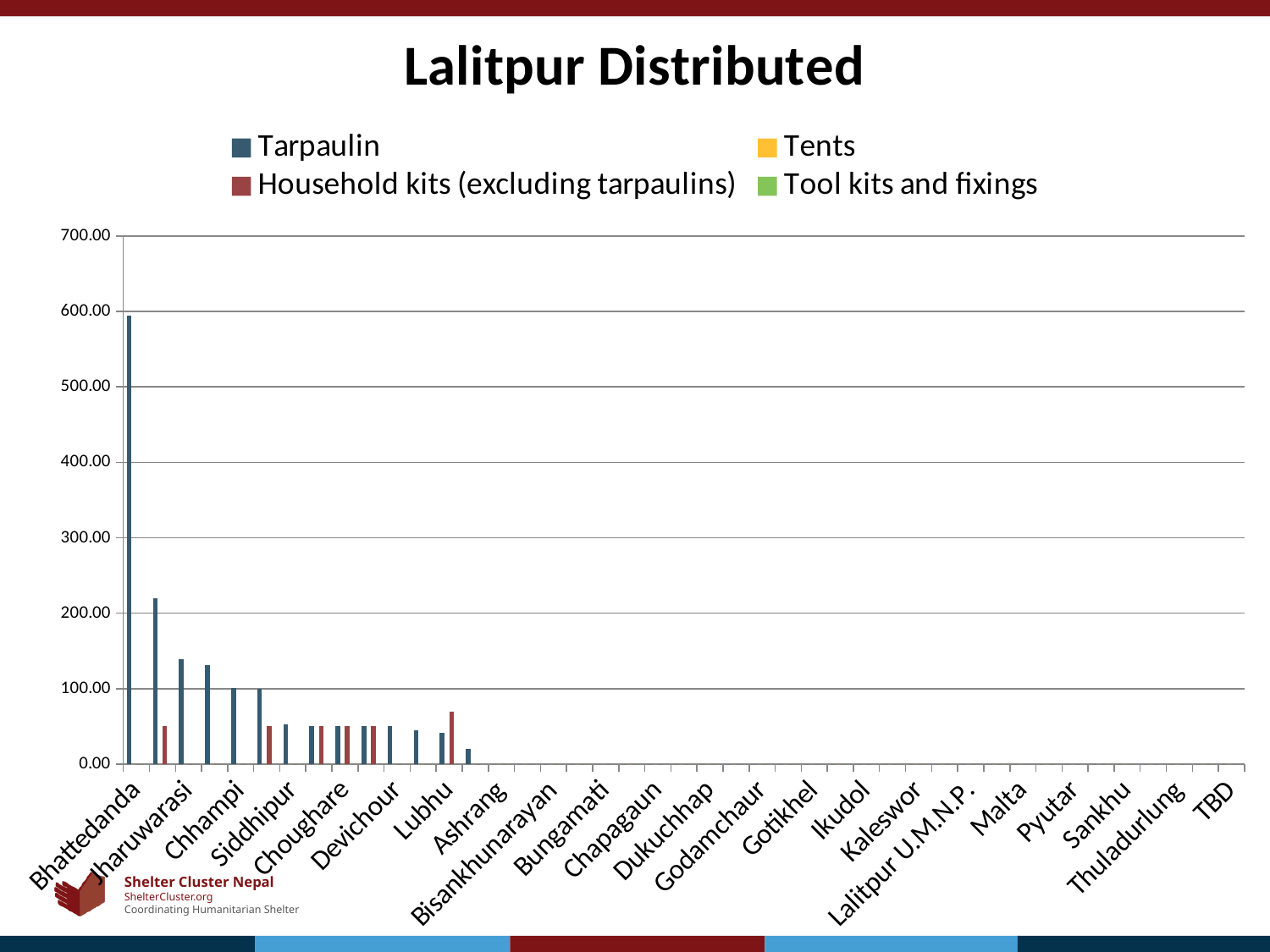
Is the Tarpaulin value for Bhattedanda greater or less than 400? greater What is the highest value shown on the vertical axis? 700.00 Is the Tarpaulin value for Bhattedanda greater or less than 500? greater Which category has the highest Tarpaulin value? Bhattedanda Which series has the tallest bar on the chart? Tarpaulin What is the title of the chart? Lalitpur Distributed Do the Tarpaulin values generally rise or fall moving from left to right along the x axis? fall What kind of chart is shown on the slide? Bar chart How many series does the legend list? 4